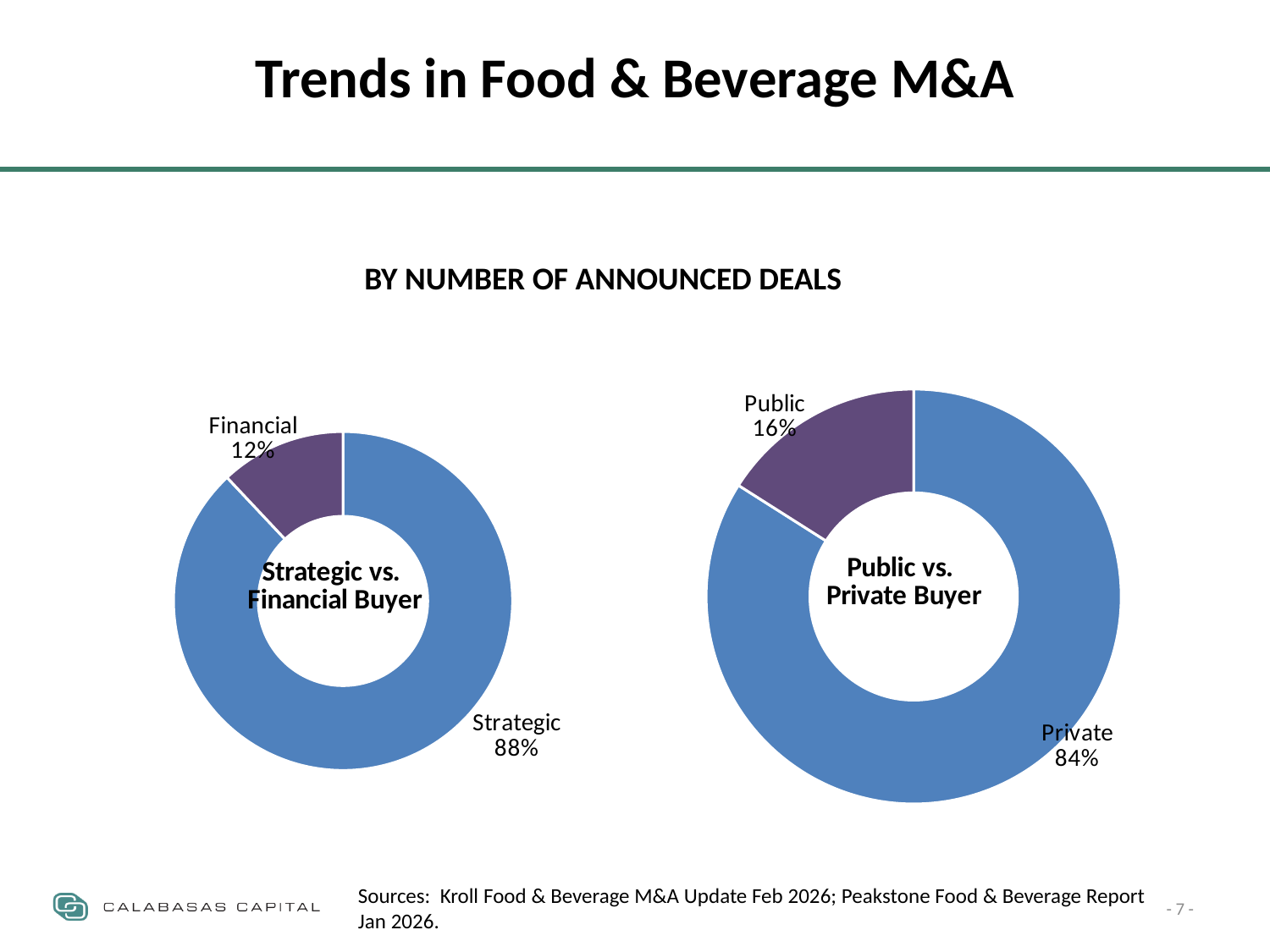
Which is larger: the Financial share in the Strategic vs. Financial Buyer chart or the Public share in the Public vs. Private Buyer chart? Public In the Strategic vs. Financial Buyer chart, which category has the largest share? Strategic How many categories does the Public vs. Private Buyer chart show? 2 In the Public vs. Private Buyer chart, what share of announced deals is attributed to Public buyers? 16% In the Strategic vs. Financial Buyer chart, what share of announced deals is attributed to Financial buyers? 12% In the Strategic vs. Financial Buyer chart, what is the difference in percentage points between the Strategic and Financial shares? 76 percentage points In the Public vs. Private Buyer chart, what share of announced deals is attributed to Private buyers? 84% In the Strategic vs. Financial Buyer chart, what share of announced deals is attributed to Strategic buyers? 88% What is the heading shown above the two charts? BY NUMBER OF ANNOUNCED DEALS What type of chart is the Strategic vs. Financial Buyer chart? Doughnut (pie) chart In the Public vs. Private Buyer chart, which category has the smallest share? Public In the Public vs. Private Buyer chart, what is the difference in percentage points between the Private and Public shares? 68 percentage points